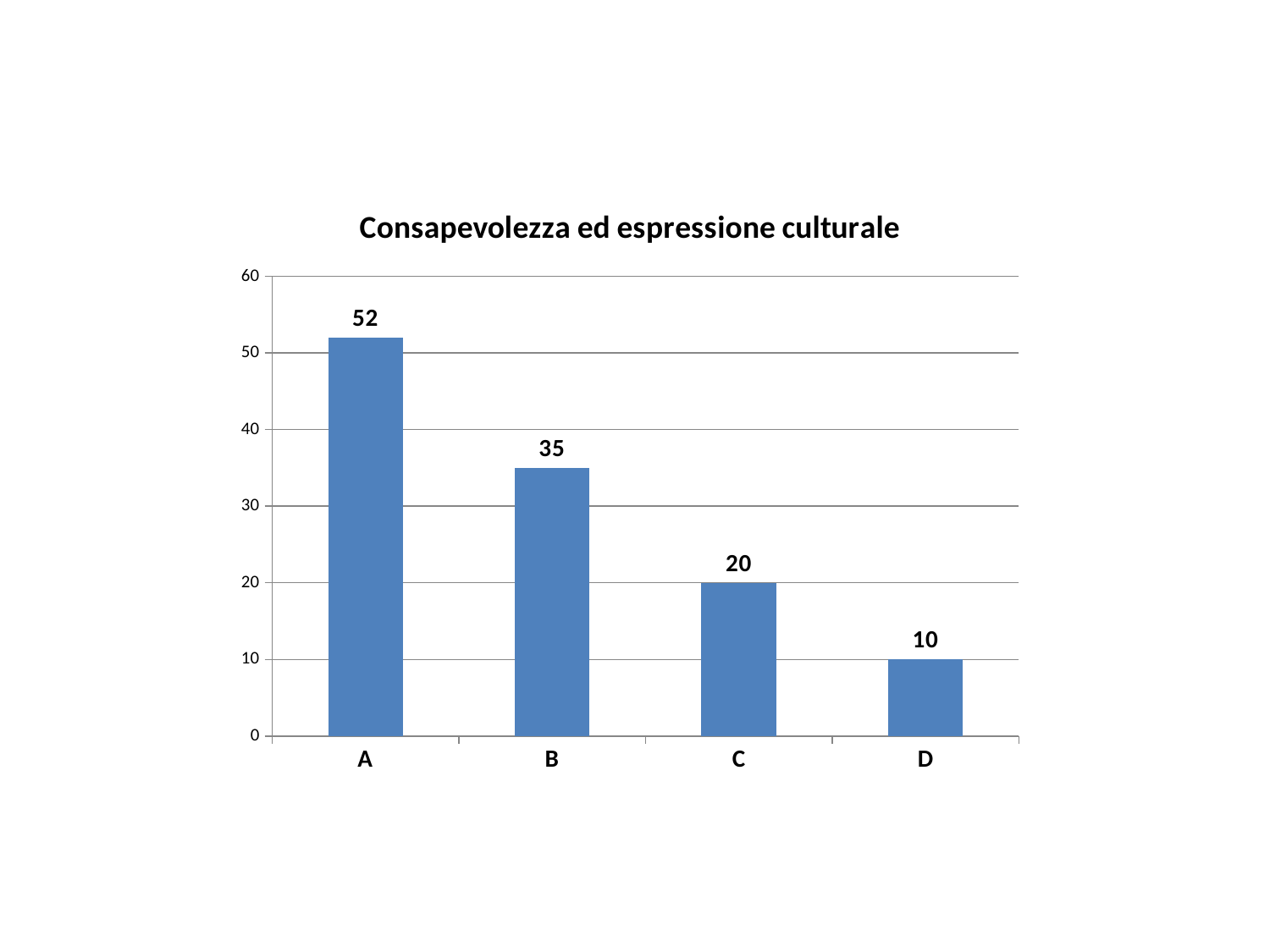
What is the value for category C? 20 What kind of chart is shown on the slide? Bar chart How many categories are shown on the x axis? 4 Is the value for B greater or less than 30? greater Which category has the highest value? A What is the title of the chart? Consapevolezza ed espressione culturale What is the value for category D? 10 What is the value for category B? 35 Which category has the lowest value? D What is the difference between the values for A and B? 17 What is the value for category A? 52 Which is larger, the value for C or the value for D? C